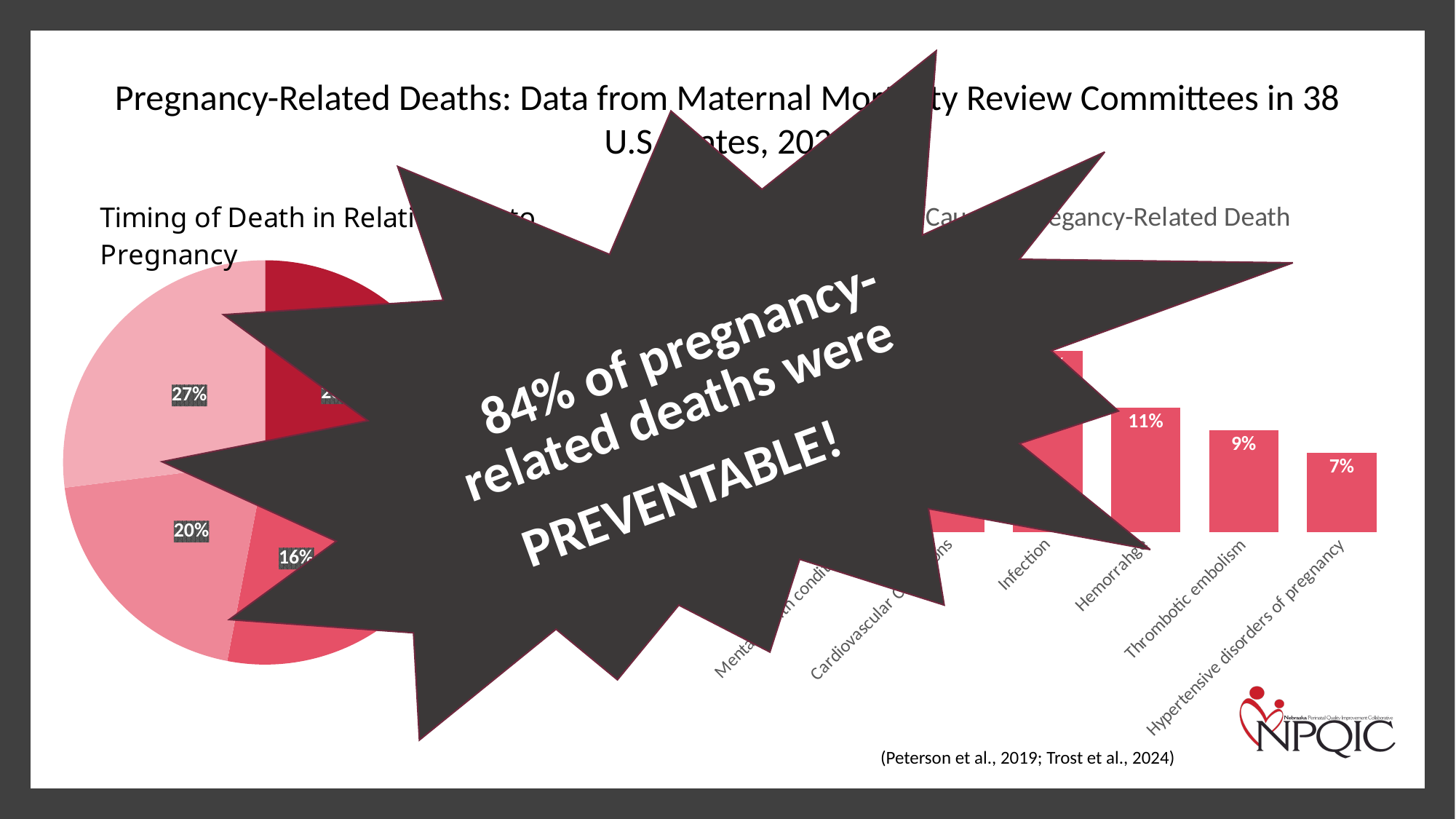
In the bar chart on the right, what is the value for Hypertensive disorders of pregnancy? 7% In the bar chart on the right, what is the value for Hemorrhage? 11% What kind of chart is the chart on the left of the slide? pie chart In the bar chart on the right, what is the difference between the values for Hemorrhage and Hypertensive disorders of pregnancy? 4% In the bar chart on the right, which is larger: Hemorrhage or Thrombotic embolism? Hemorrhage In the bar chart on the right, do the values rise or fall from Hemorrhage to Hypertensive disorders of pregnancy? fall In the bar chart on the right, among Hemorrhage, Thrombotic embolism and Hypertensive disorders of pregnancy, which has the lowest value? Hypertensive disorders of pregnancy In the bar chart on the right, what is the value for Thrombotic embolism? 9% What percentage of pregnancy-related deaths does the starburst overlay on the slide say were preventable? 84% What kind of chart is the chart on the right of the slide? bar chart In the bar chart on the right, what is the difference between the values for Hemorrhage and Thrombotic embolism? 2% In the bar chart on the right, which is larger: Thrombotic embolism or Hypertensive disorders of pregnancy? Thrombotic embolism